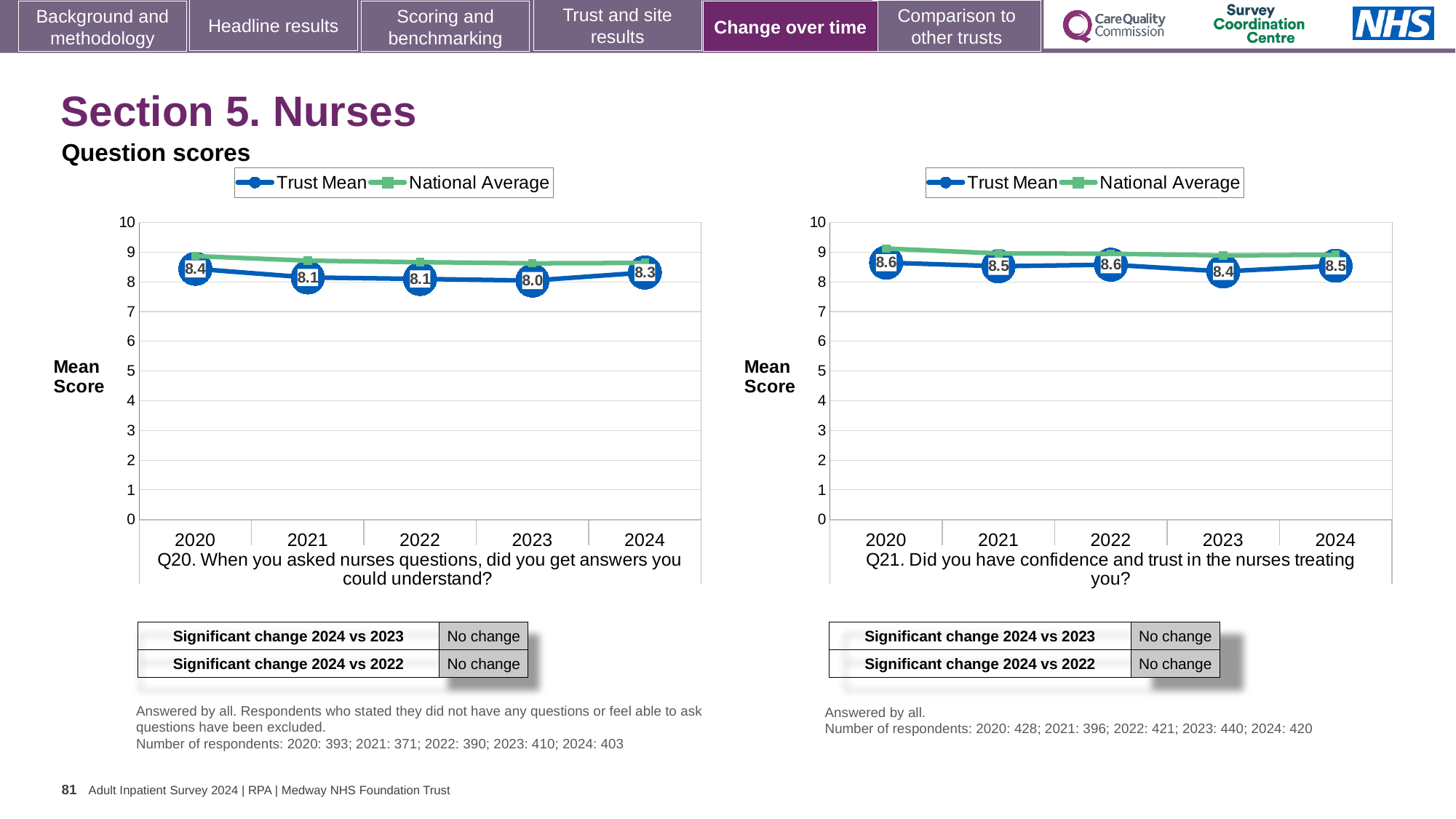
In the Q21 chart (right), which year has the lowest Trust Mean score? 2023 In the Q20 chart (left), what is the difference between the Trust Mean scores for 2024 and 2023? 0.3 In the Q20 chart (left), which year has the highest Trust Mean score? 2020 In the Q20 chart (left), what is the Trust Mean score for 2023? 8.0 In the Q20 chart (left), does the Trust Mean score rise or fall from 2020 to 2023? Fall In the Q21 chart (right), which is larger, the Trust Mean score for 2022 or for 2023? 2022 In the Q21 chart (right), what is the Trust Mean score for 2020? 8.6 What is the label on the y axis of the Q20 chart (left)? Mean Score In the Q20 chart (left), is the National Average value for 2020 greater or less than 8? greater How many series does the legend of the Q20 chart (left) list? 2 What kind of chart is the Q21 chart (right)? Line chart How many years are plotted on the x axis of the Q21 chart (right)? 5